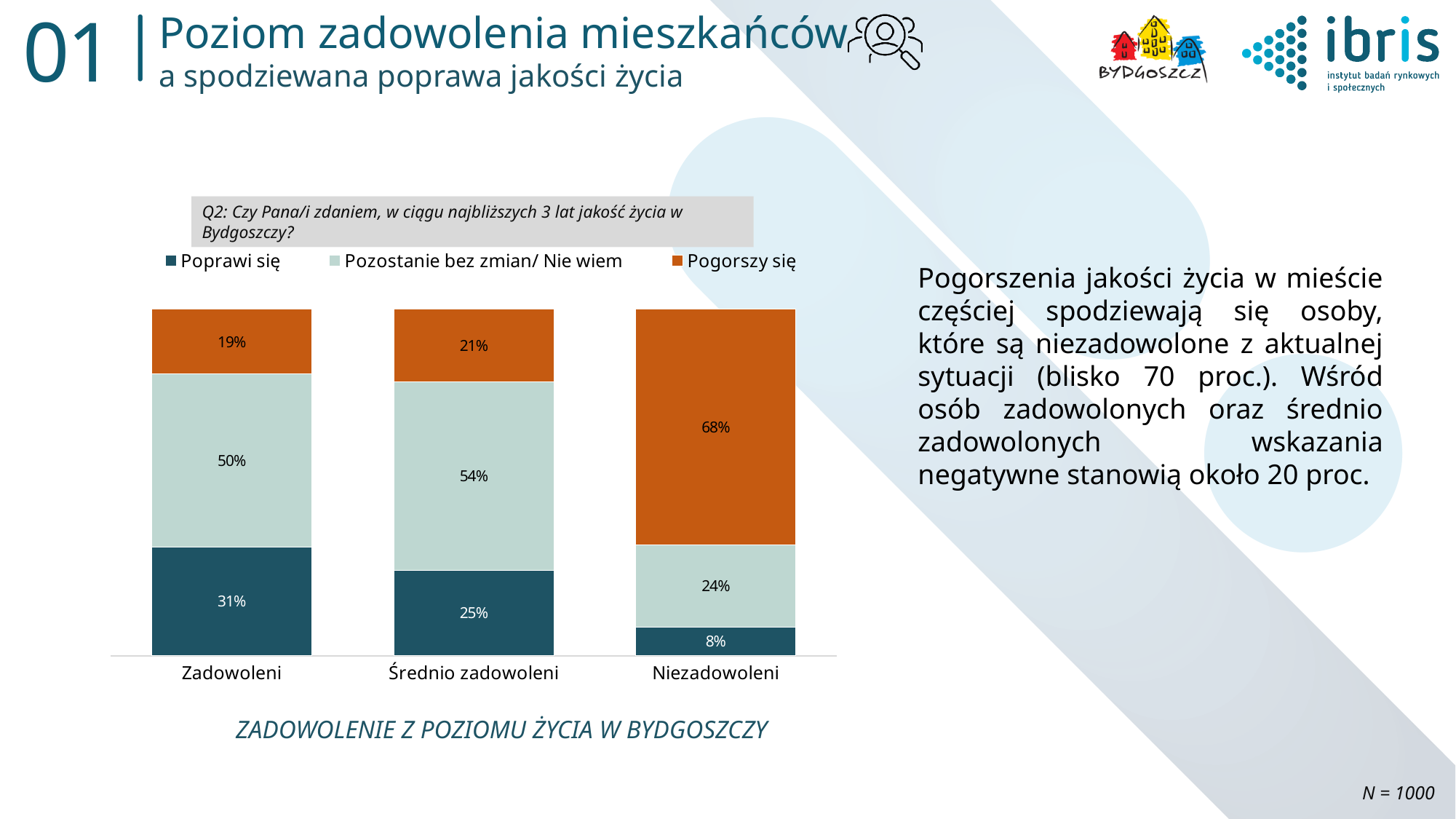
How many categories are shown on the x axis? 3 What is the total of the stacked bar for "Średnio zadowoleni"? 100% What is the value for "Pogorszy się" in the "Niezadowoleni" category? 68% Which category has the lowest value for "Poprawi się"? Niezadowoleni What is the value for "Poprawi się" in the "Zadowoleni" category? 31% What kind of chart is shown on the slide? Stacked bar chart Which is larger: "Poprawi się" for "Zadowoleni" or "Poprawi się" for "Średnio zadowoleni"? Zadowoleni Which series is shown in orange in the legend? Pogorszy się What is the value for "Pozostanie bez zmian/ Nie wiem" in the "Średnio zadowoleni" category? 54% Which category has the highest value for "Pogorszy się"? Niezadowoleni What is the difference between the "Pogorszy się" values for "Niezadowoleni" and "Zadowoleni"? 49 percentage points How many series does the legend list? 3